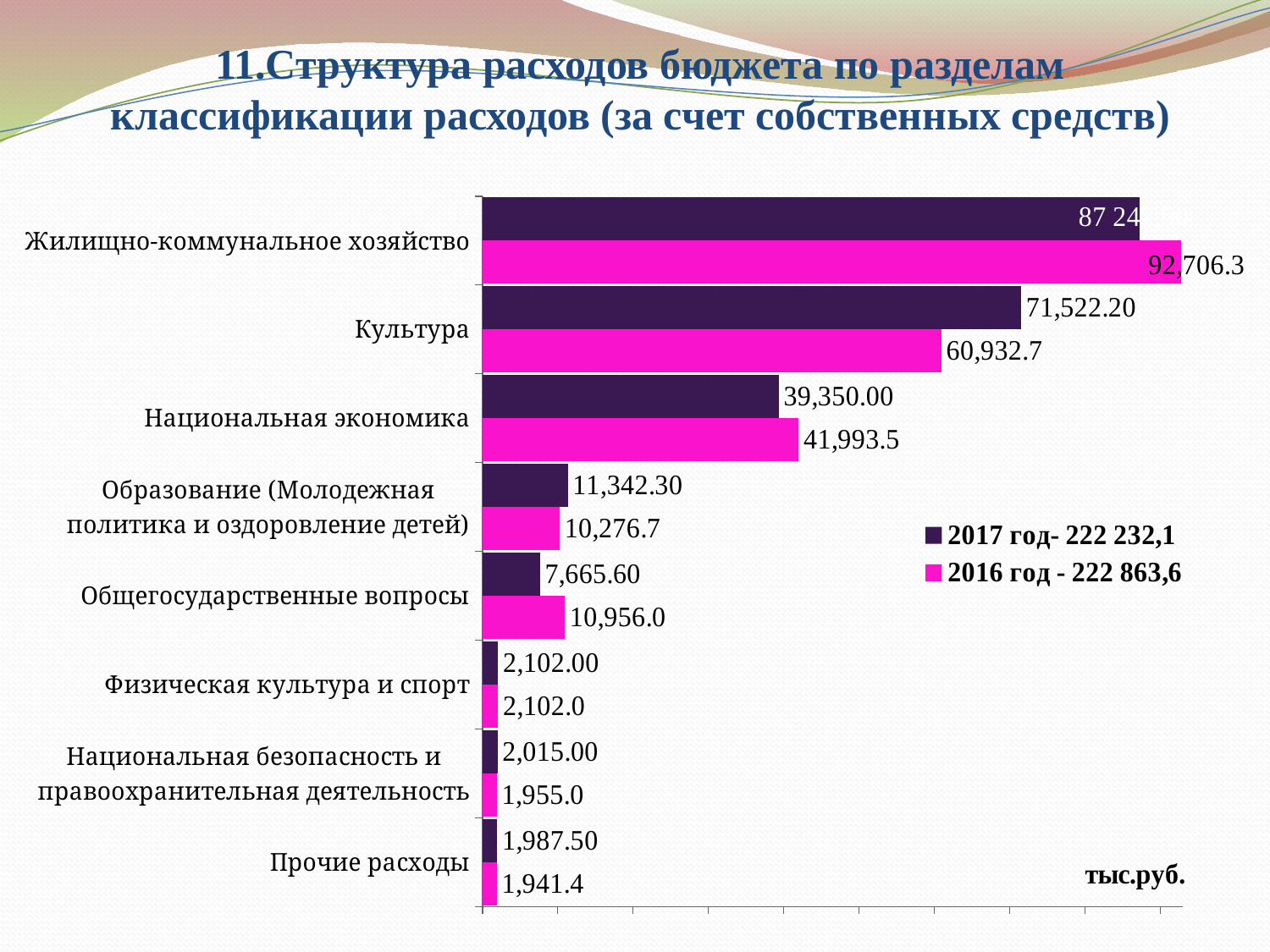
How many series does the legend list? 2 Which category has the lowest 2017 год value? Прочие расходы Which is larger for Культура: the 2017 год value or the 2016 год value? 2017 год What is the 2016 год value for Прочие расходы? 1,941.4 What is the 2016 год value for Жилищно-коммунальное хозяйство? 92,706.3 How many categories are shown on the chart? 8 What kind of chart is shown on the slide? bar chart What is the 2017 год value for Общегосударственные вопросы? 7,665.60 Which category has the highest 2016 год value? Жилищно-коммунальное хозяйство What is the 2017 год value for Культура? 71,522.20 What is the 2016 год value for Национальная экономика? 41,993.5 What is the difference between the 2016 год and 2017 год values for Общегосударственные вопросы? 3,290.4